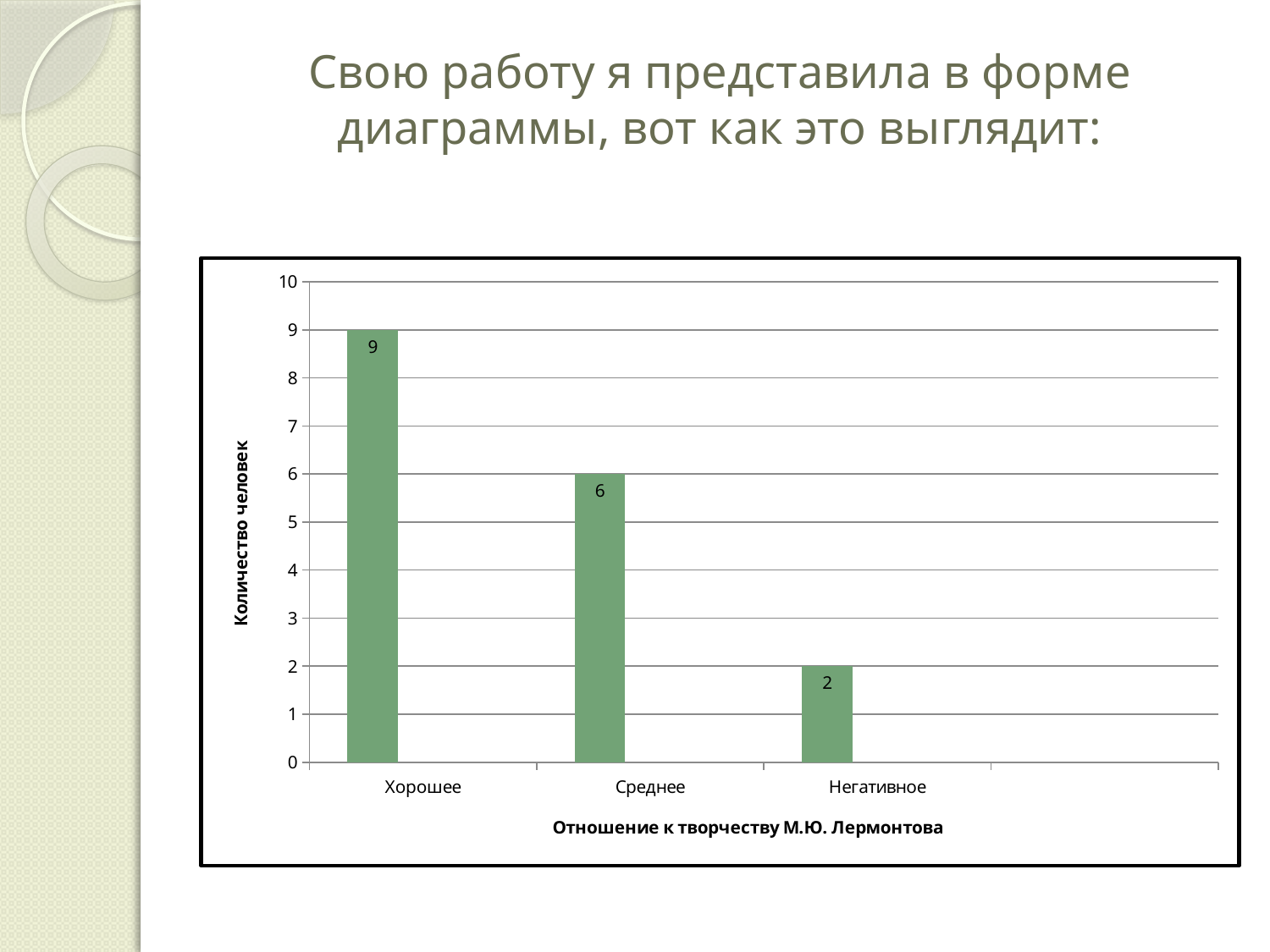
What is the value for Среднее? 6 What is the difference between the values for Среднее and Негативное? 4 What is the label of the x axis? Отношение к творчеству М.Ю. Лермонтова What is the value for Негативное? 2 What kind of chart is shown on the slide? bar chart What is the difference between the values for Хорошее and Среднее? 3 What is the value for Хорошее? 9 Which category has the highest value? Хорошее Is the value for Хорошее greater or less than 5? greater How many categories are shown on the x axis? 3 Which is larger, the value for Среднее or the value for Негативное? Среднее Which category has the lowest value? Негативное